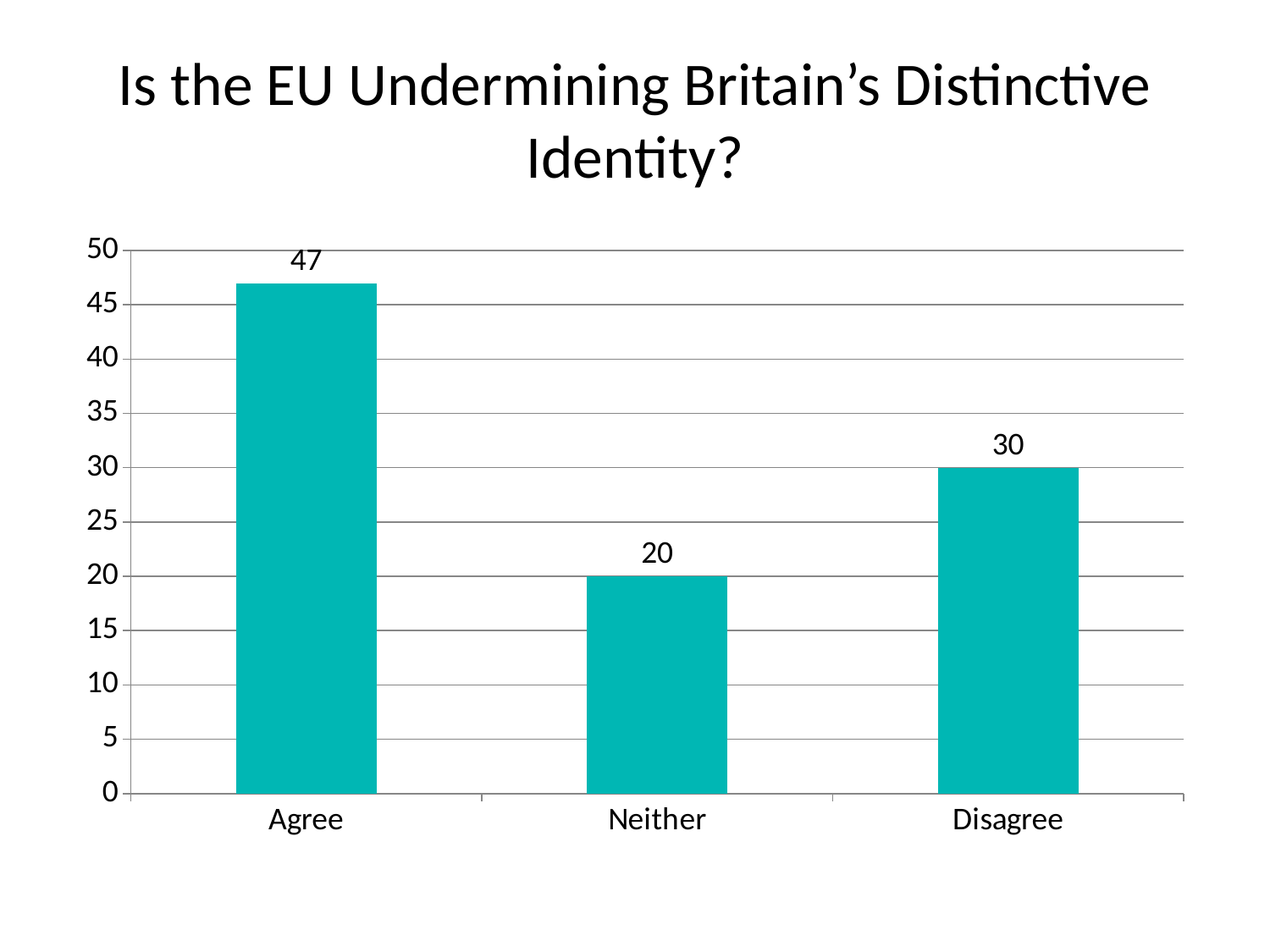
Is the value for Agree greater or less than 40? greater What is the title of the slide? Is the EU Undermining Britain's Distinctive Identity? How many categories are shown on the x axis? 3 Which is larger, the value for Neither or the value for Disagree? Disagree Which category has the lowest value? Neither What is the difference between the values for Disagree and Neither? 10 What kind of chart is shown on the slide? bar chart What is the value for Disagree? 30 What is the value for Neither? 20 Which category has the highest value? Agree What is the difference between the values for Agree and Disagree? 17 What is the value for Agree? 47